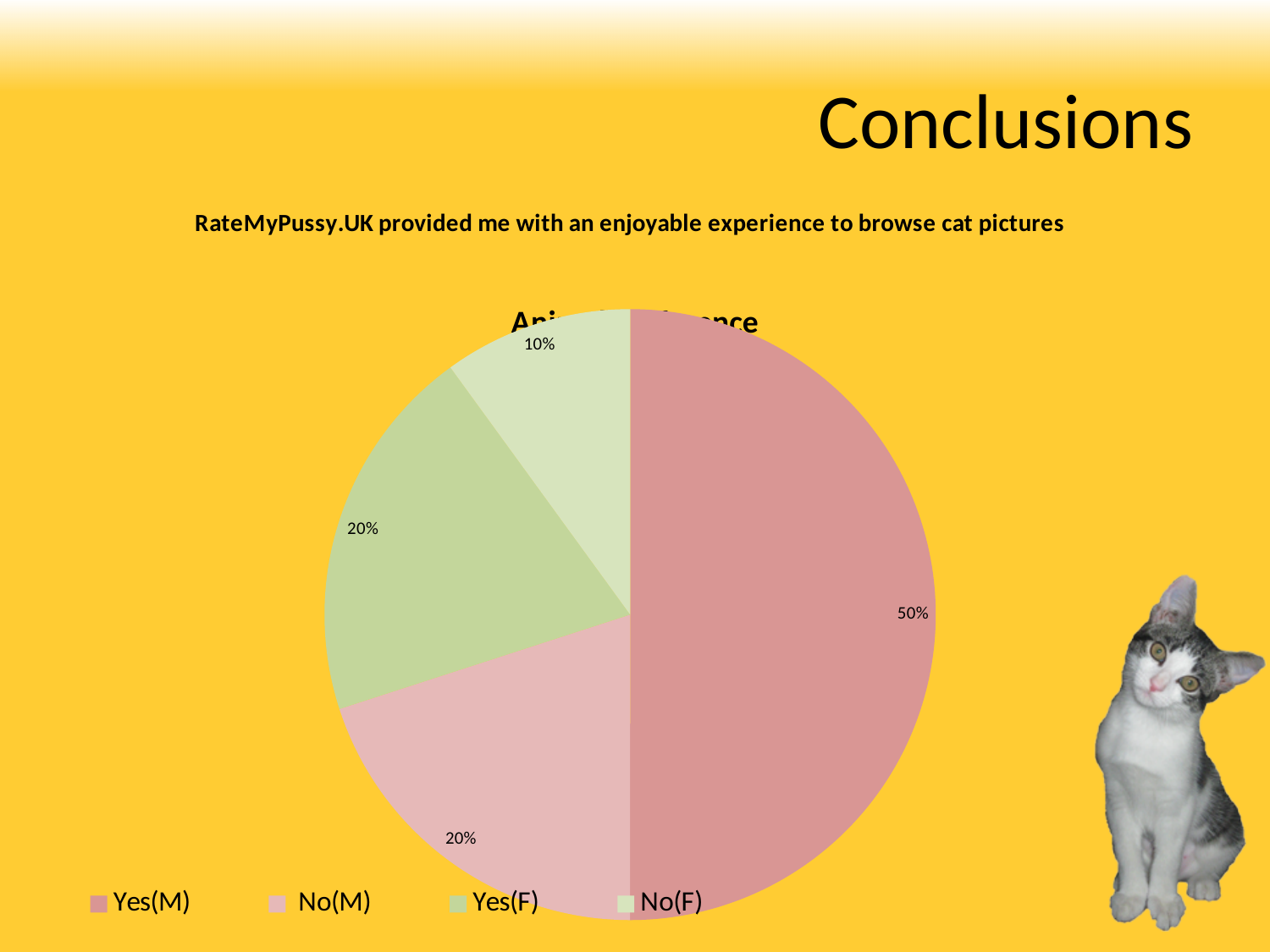
What is the difference in percentage points between Yes(M) and No(F)? 40% What kind of chart is shown on the slide? pie chart What is the combined share of Yes(M) and Yes(F)? 70% What share of the pie does No(F) have? 10% What share of the pie does Yes(F) have? 20% What share of the pie does No(M) have? 20% Which slice of the pie is the largest? Yes(M) Which is larger, the Yes(M) slice or the No(M) slice? Yes(M) How many slices does the pie chart have? 4 Which slice of the pie is the smallest? No(F) What share of the pie does Yes(M) have? 50% How many entries does the legend list? 4